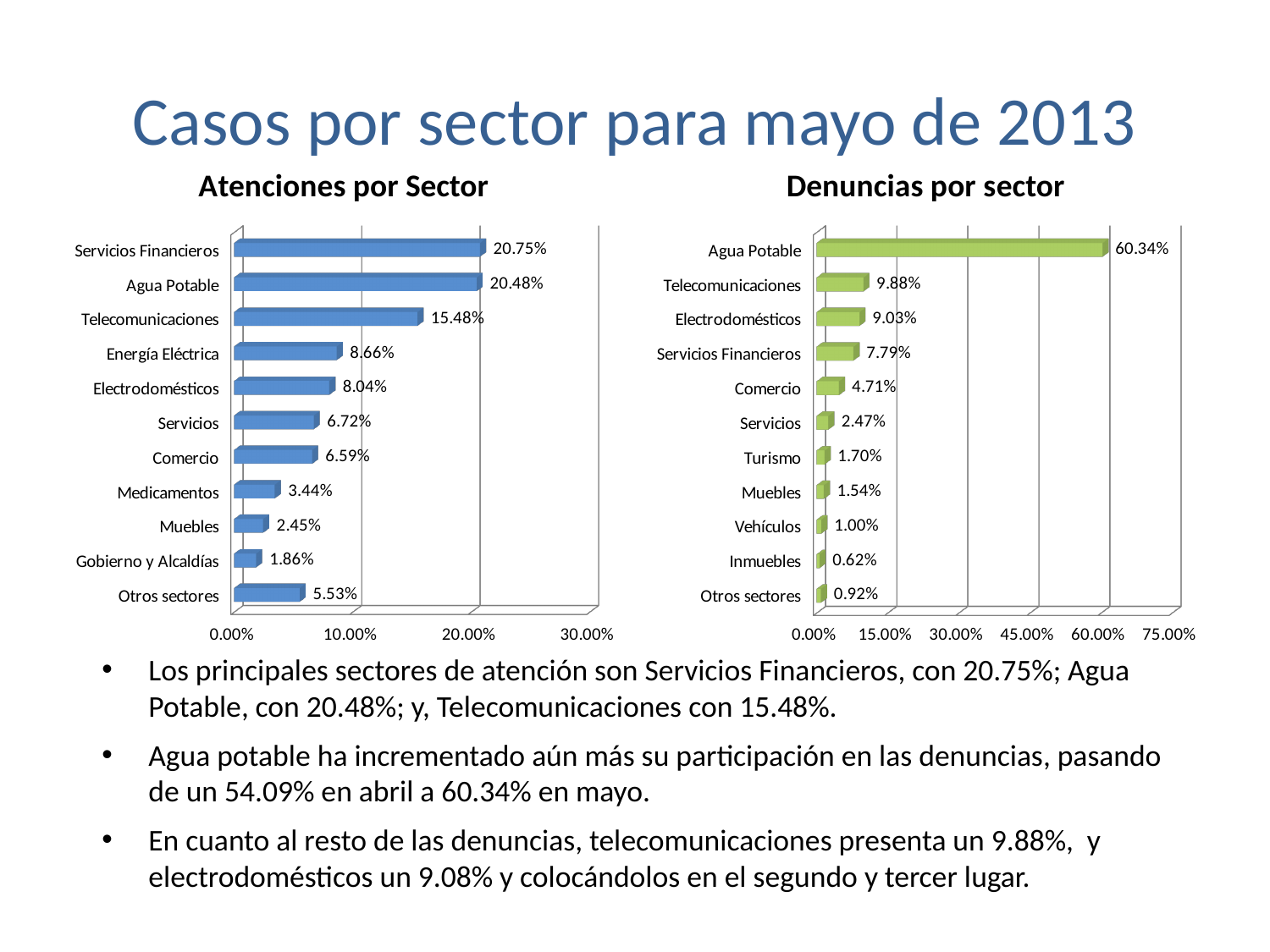
What kind of chart is 'Atenciones por Sector'? Bar chart In the 'Atenciones por Sector' chart, which sector has the lowest value? Gobierno y Alcaldías How many sectors are shown in the 'Denuncias por sector' chart? 11 In the 'Denuncias por sector' chart, is the value for Agua Potable greater or less than 45.00%? greater In the 'Denuncias por sector' chart, what is the value for Agua Potable? 60.34% In the 'Denuncias por sector' chart, which sector has the lowest value? Inmuebles In the 'Atenciones por Sector' chart, which sector has the highest value? Servicios Financieros In the 'Atenciones por Sector' chart, which is larger, Energía Eléctrica or Electrodomésticos? Energía Eléctrica In the 'Atenciones por Sector' chart, what is the difference between Servicios Financieros and Agua Potable? 0.27% In the 'Denuncias por sector' chart, what is the difference between Telecomunicaciones and Electrodomésticos? 0.85% In the 'Atenciones por Sector' chart, what is the value for Telecomunicaciones? 15.48% In the 'Denuncias por sector' chart, what is the value for Comercio? 4.71%